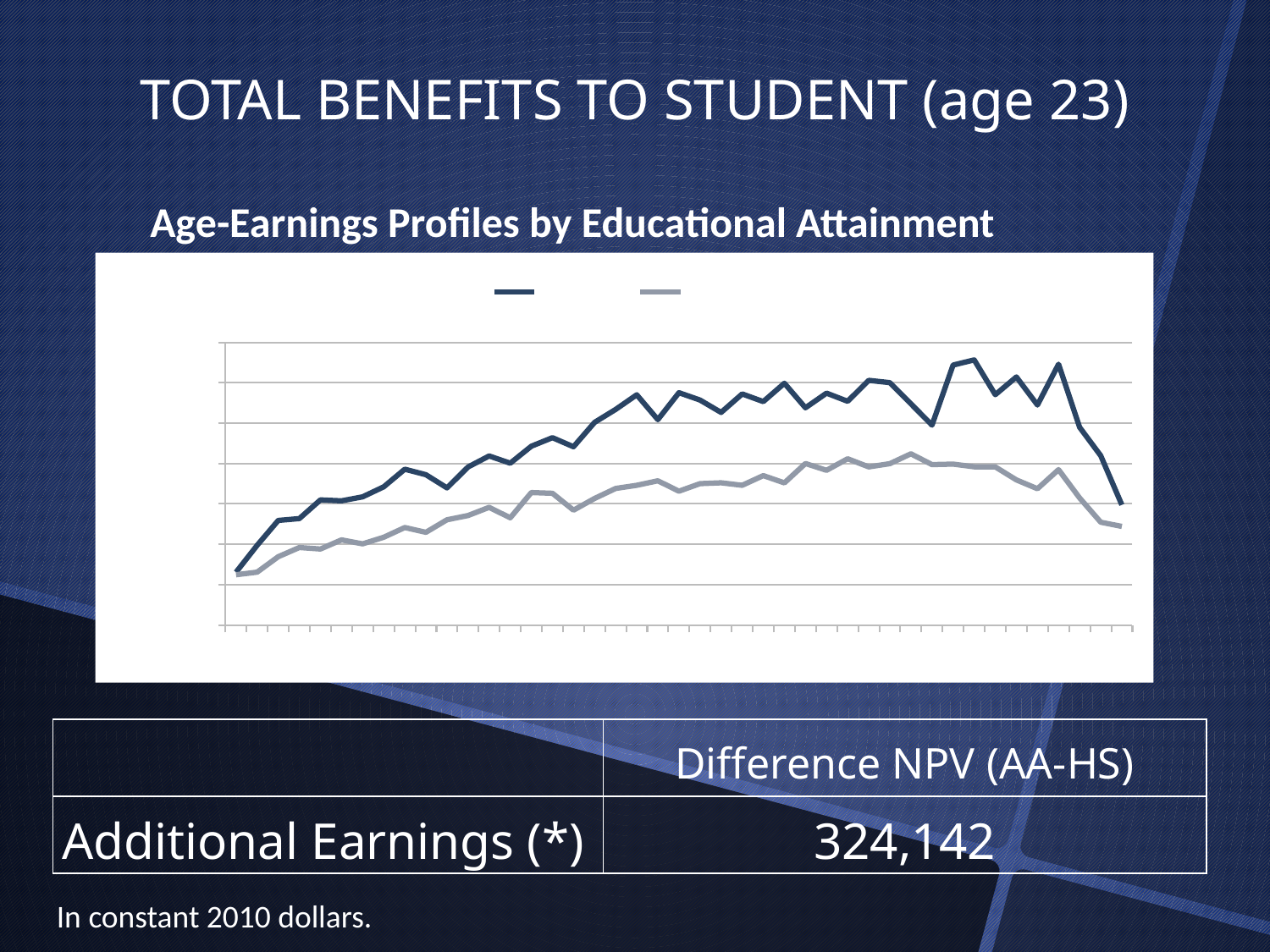
In the Age-Earnings Profiles chart, which line is plotted higher across the x axis, the dark navy line or the grey line? the dark navy line What two colours are used for the lines in the Age-Earnings Profiles chart? dark navy and grey In the Age-Earnings Profiles chart, do the values of the dark navy line generally rise or fall across the first half of the x axis? rise What kind of chart is shown under the heading "Age-Earnings Profiles by Educational Attainment"? line chart In the Age-Earnings Profiles chart, do the values of both lines rise or fall over the last few points on the x axis? fall How many series does the legend of the Age-Earnings Profiles chart list? 2 What is the title of the chart on the slide? Age-Earnings Profiles by Educational Attainment